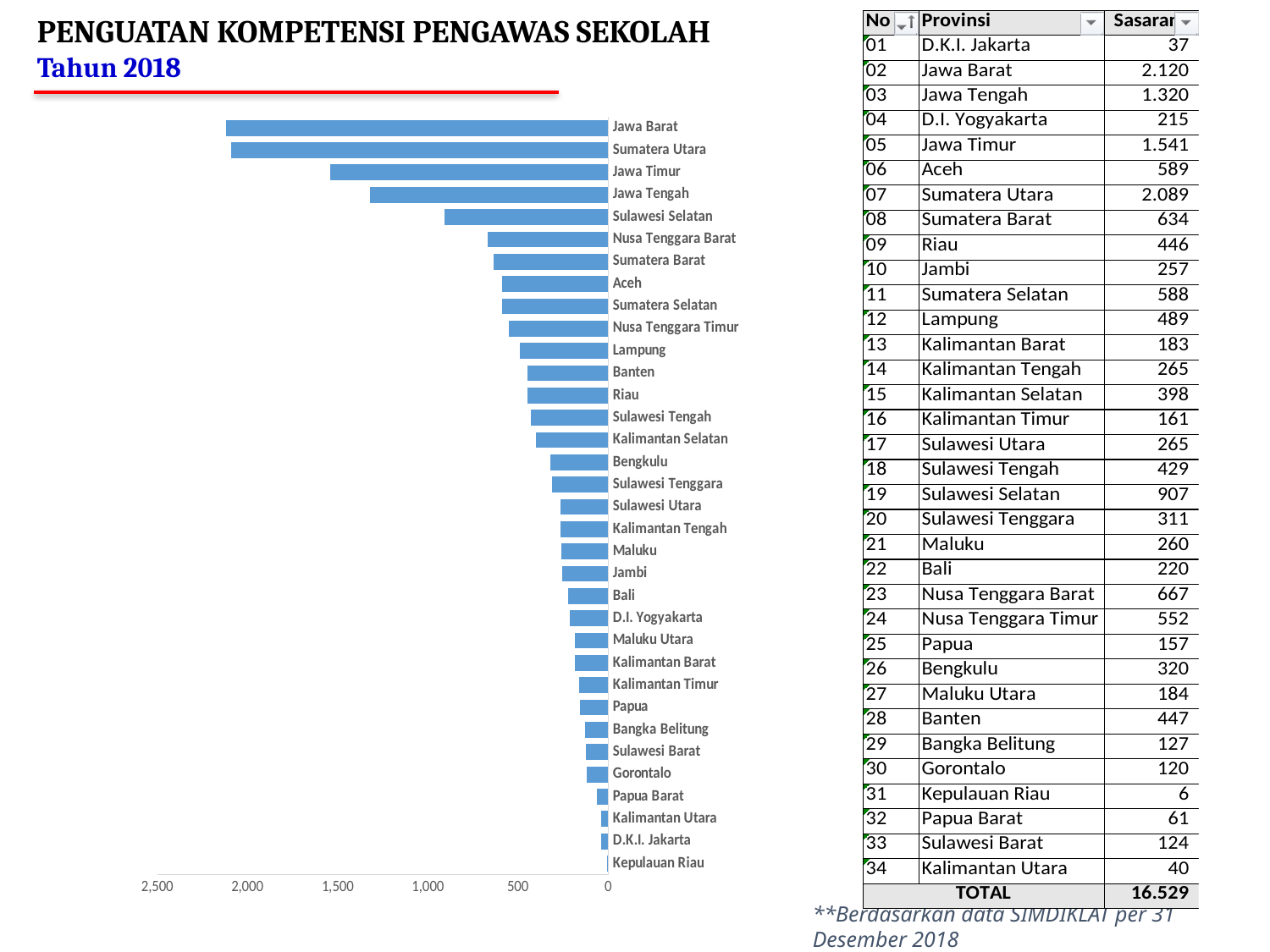
According to the table, what is the Sasaran value for Sulawesi Selatan? 907 Is the value for Aceh in the bar chart greater or less than 500? greater How many provinces are shown in the bar chart? 34 What is the difference between the Sasaran values for Jawa Barat and Sumatera Utara shown in the table? 31 According to the table, what is the Sasaran value for Papua Barat? 61 What is the TOTAL Sasaran value shown at the bottom of the table? 16.529 What kind of chart is shown on the slide? bar chart According to the table, what is the Sasaran value for Jawa Barat? 2.120 Which province has the highest value in the bar chart? Jawa Barat Which has the larger value in the bar chart, Jawa Timur or Jawa Tengah? Jawa Timur Which province has the lowest value in the bar chart? Kepulauan Riau Is the value for Jawa Tengah in the bar chart greater or less than 1,500? less